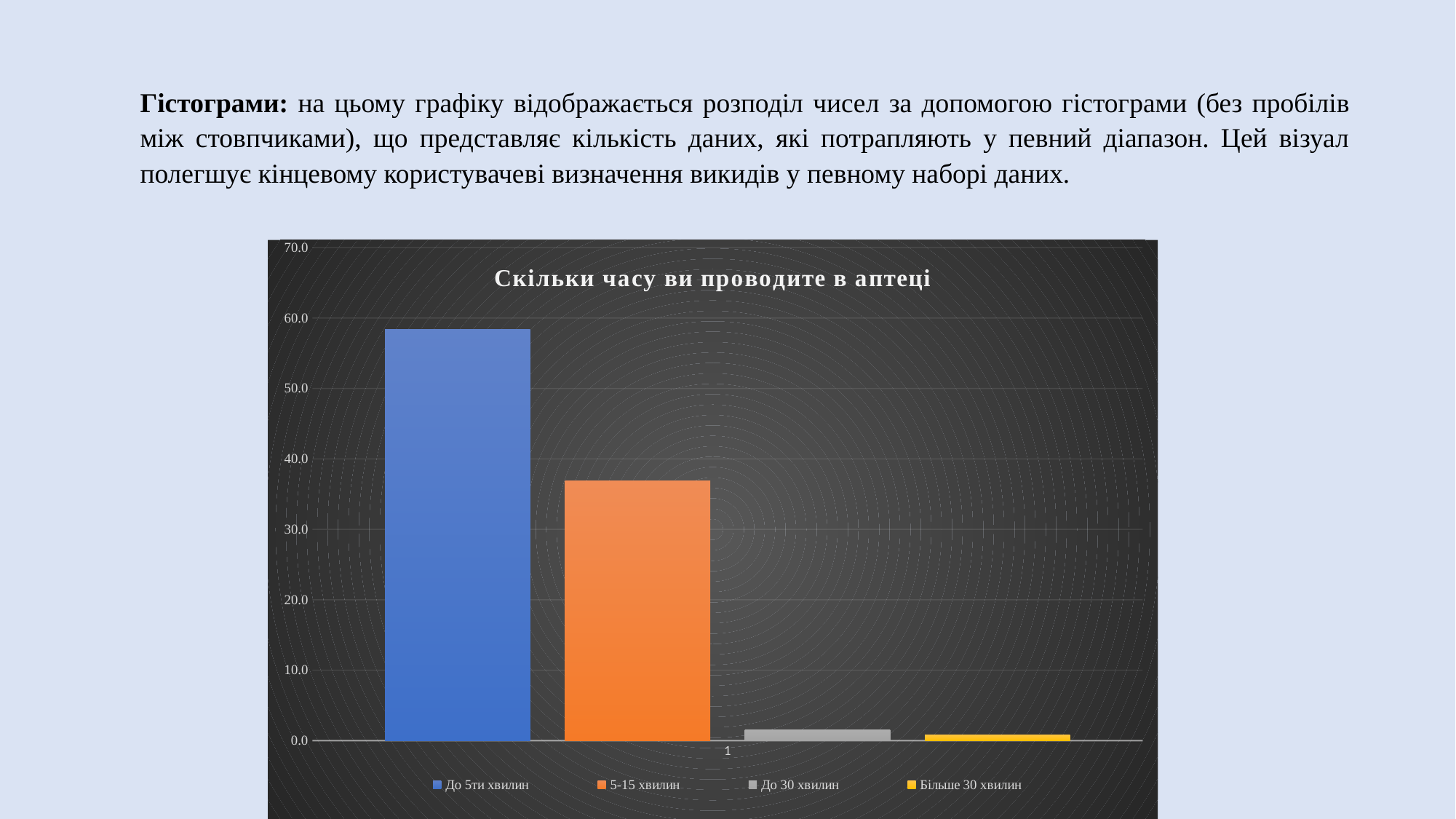
Which series has the highest value? До 5ти хвилин Which is larger, the value for До 5ти хвилин or the value for 5-15 хвилин? До 5ти хвилин Is the value for До 5ти хвилин greater or less than 50.0? greater How many bars are plotted in the chart? 4 How many series does the legend list? 4 What is the title of the chart? Скільки часу ви проводите в аптеці Which is larger, the value for 5-15 хвилин or the value for До 30 хвилин? 5-15 хвилин Which colour represents the series 5-15 хвилин in the legend? orange Is the value for 5-15 хвилин greater or less than 40.0? less Is the value for До 30 хвилин greater or less than 10.0? less What kind of chart is shown on the slide? bar chart Which series has the lowest value? Більше 30 хвилин